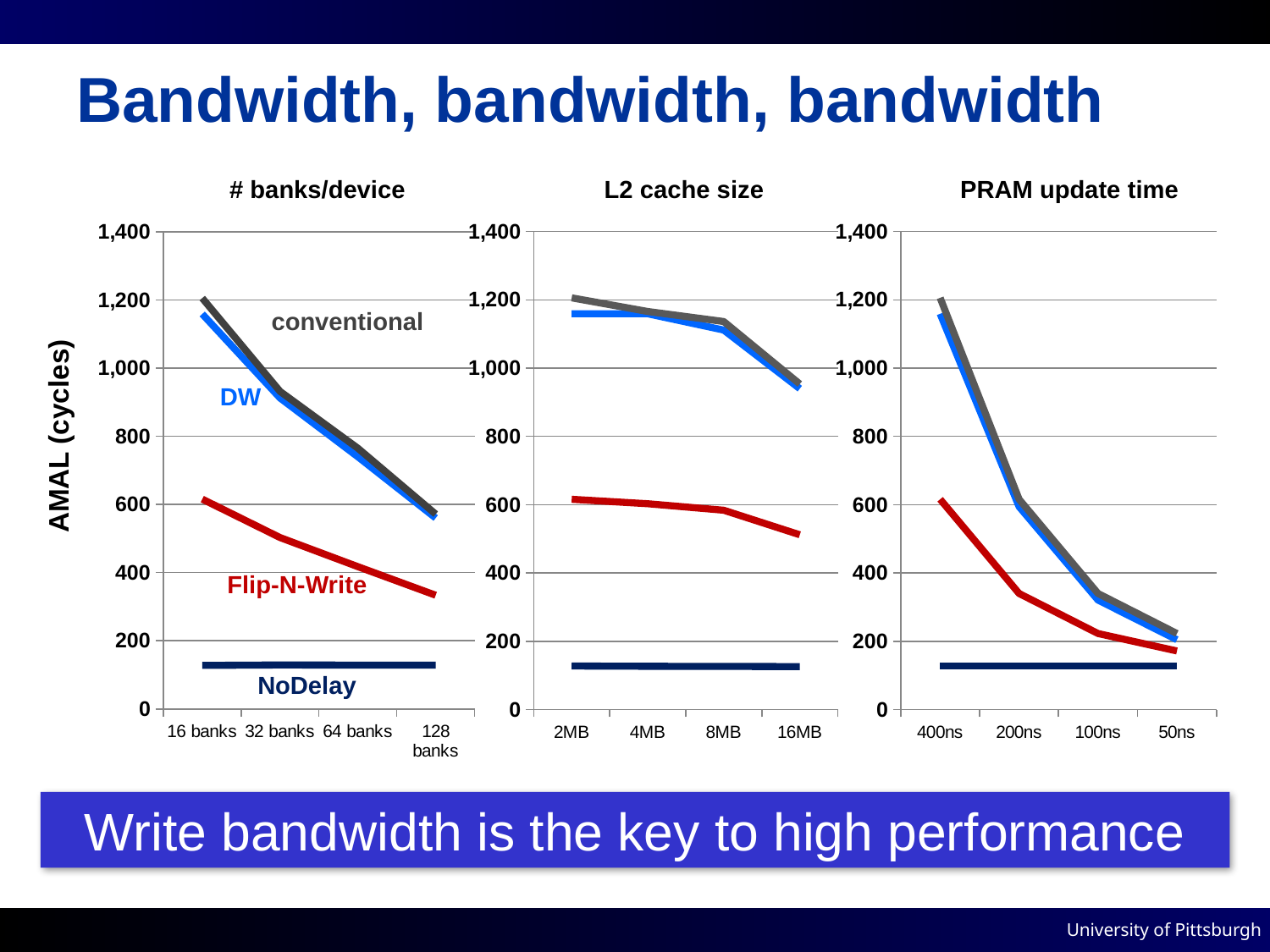
In the "PRAM update time" chart, which series has the lowest value at 50ns? NoDelay In the "# banks/device" chart, is the Flip-N-Write value at 128 banks greater or less than 400? less How many categories are on the x axis of the "L2 cache size" chart? 4 How many categories are on the x axis of the "PRAM update time" chart? 4 In the "PRAM update time" chart, is the Flip-N-Write value at 200ns greater or less than 400? less In the "PRAM update time" chart, is the conventional value at 400ns greater or less than 1,000? greater In the "# banks/device" chart, which is larger at 16 banks: conventional or Flip-N-Write? conventional How many series are plotted in the "# banks/device" chart? 4 What kind of chart is the "# banks/device" chart? line chart In the "L2 cache size" chart, does the Flip-N-Write line rise or fall from 2MB to 16MB? fall In the "# banks/device" chart, does the conventional line rise or fall as the number of banks increases? fall